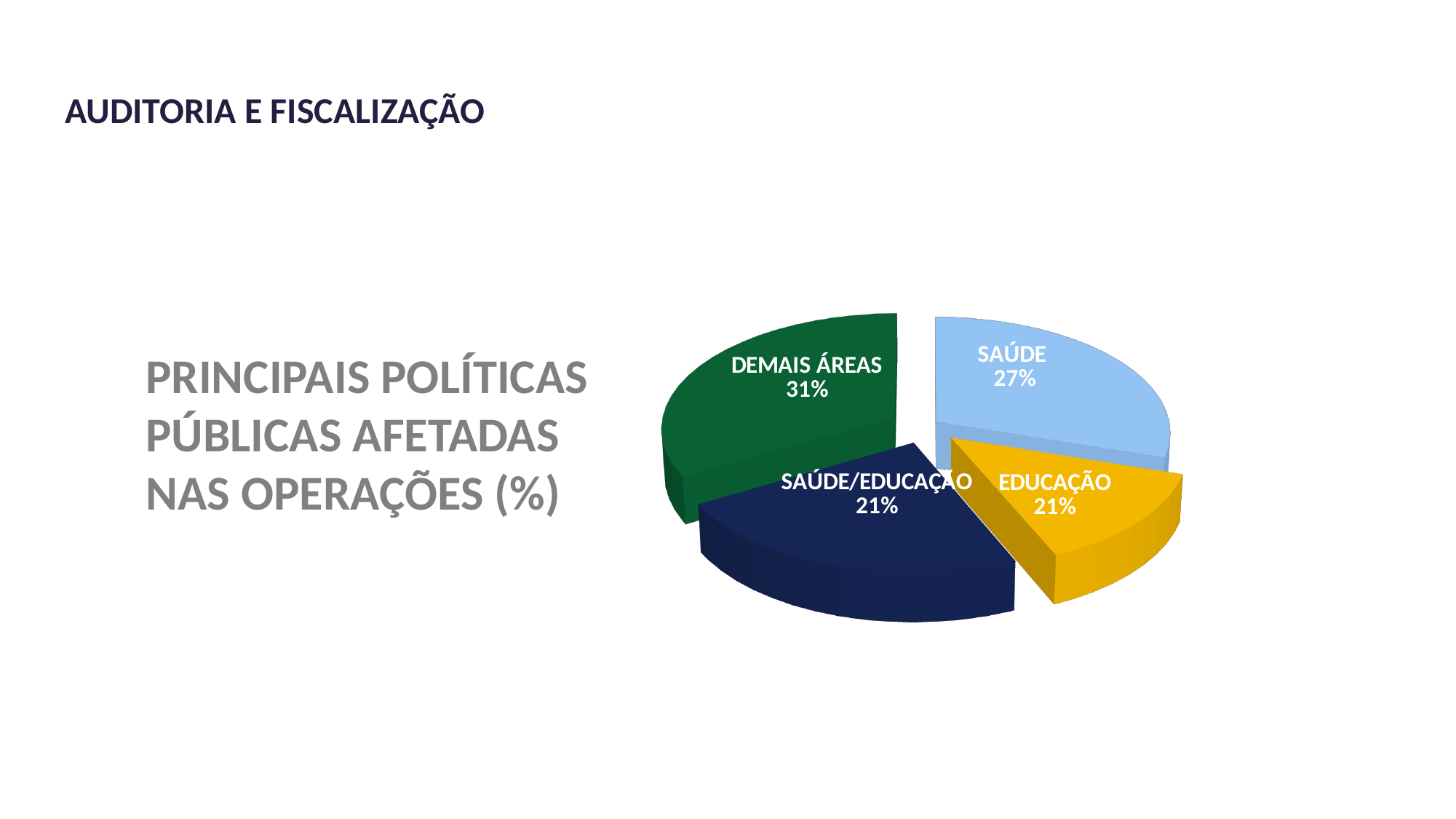
What percentage does the SAÚDE/EDUCAÇÃO slice represent? 21% Which is larger, the SAÚDE slice or the EDUCAÇÃO slice? SAÚDE What is the title of the pie chart? PRINCIPAIS POLÍTICAS PÚBLICAS AFETADAS NAS OPERAÇÕES (%) Which slice has the largest share of the pie? DEMAIS ÁREAS What is the difference in percentage points between DEMAIS ÁREAS and SAÚDE? 4 What colour is the DEMAIS ÁREAS slice? Green What percentage does the DEMAIS ÁREAS slice represent? 31% What is the difference in percentage points between SAÚDE and EDUCAÇÃO? 6 What type of chart is shown on the slide? Pie chart What percentage does the EDUCAÇÃO slice represent? 21% What percentage does the SAÚDE slice represent? 27% How many slices does the pie chart have? 4